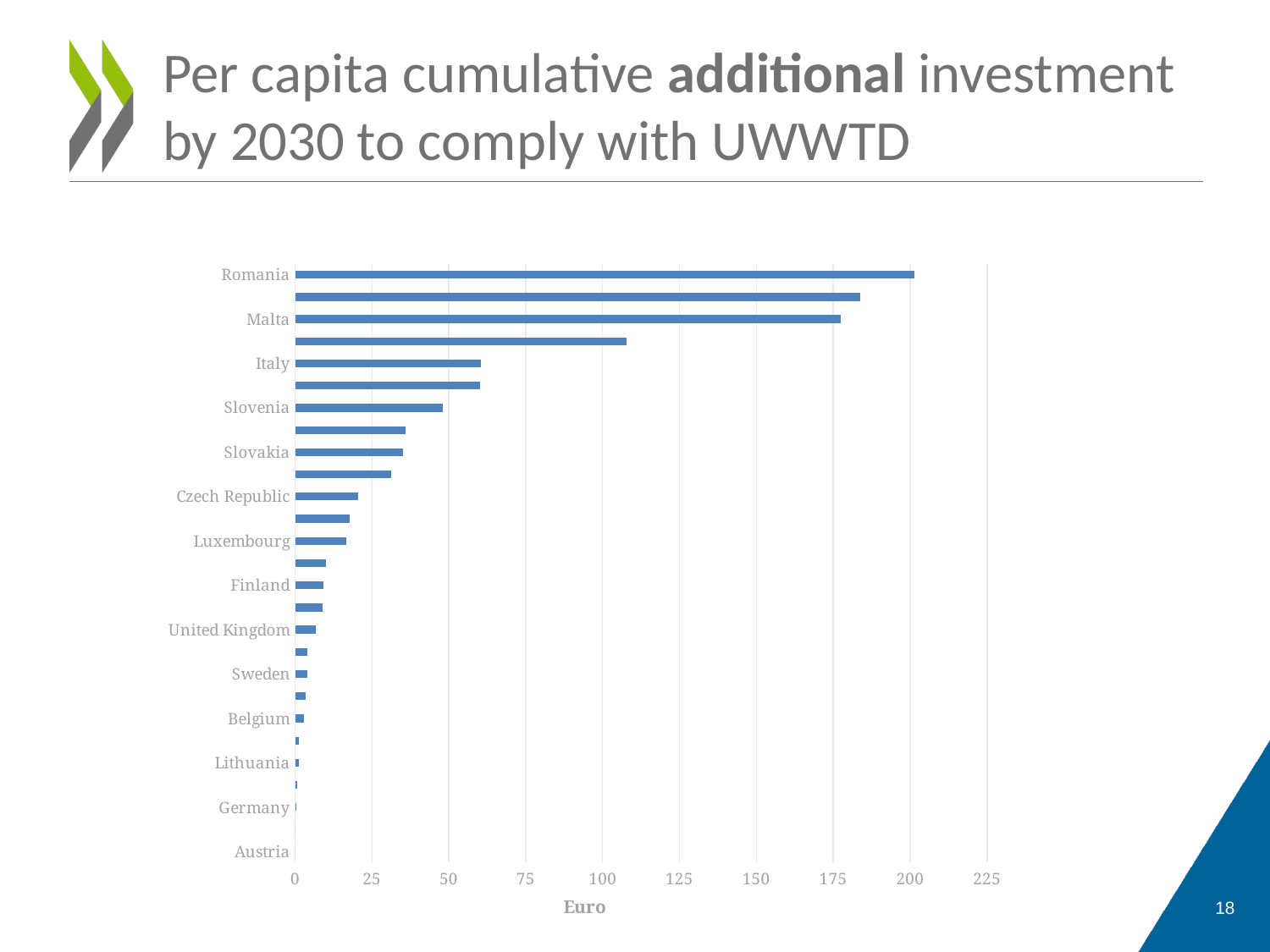
Is the value for Italy greater or less than 75? less Which country has the highest per capita cumulative additional investment? Romania Is the value for Slovakia greater or less than 25? greater What is the title of the horizontal axis? Euro How many country labels are shown on the vertical axis? 14 Is the value for Czech Republic greater or less than 25? less What kind of chart is shown on the slide? bar chart Do the bar values increase or decrease going from the top of the chart to the bottom? decrease Which has a larger value, Romania or Malta? Romania Which has a larger value, Italy or Slovenia? Italy